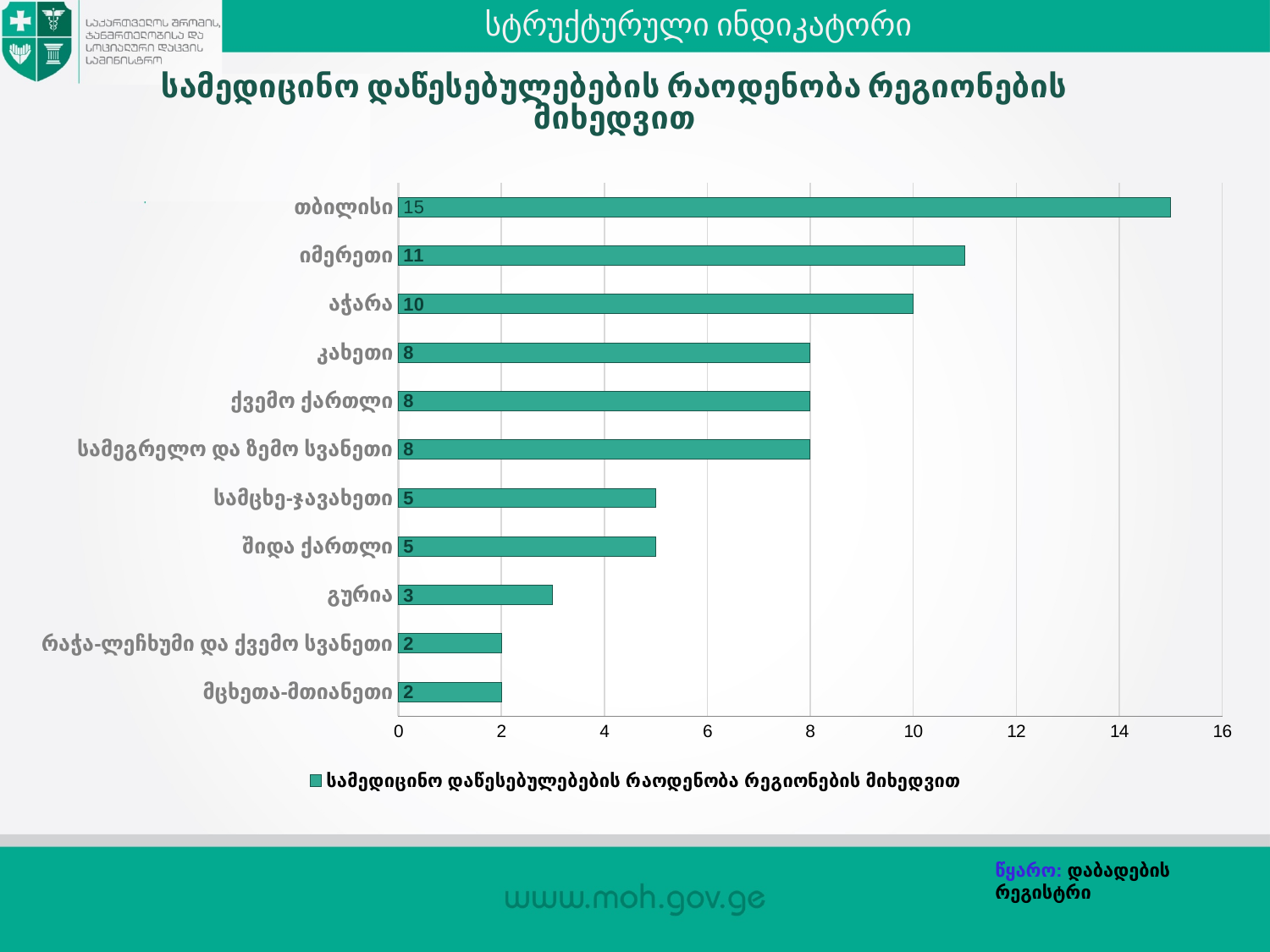
How many series does the legend list? 1 What is the value for იმერეთი? 11 Is the value for იმერეთი greater or less than 10? greater What is the value for თბილისი? 15 What is the difference between the values for იმერეთი and კახეთი? 3 Which is larger, the value for აჭარა or the value for შიდა ქართლი? აჭარა How many regions are shown in the chart? 11 What is the value for სამცხე-ჯავახეთი? 5 What is the difference between the values for თბილისი and აჭარა? 5 Which region has the highest value? თბილისი What kind of chart is shown on the slide? bar chart What is the value for გურია? 3